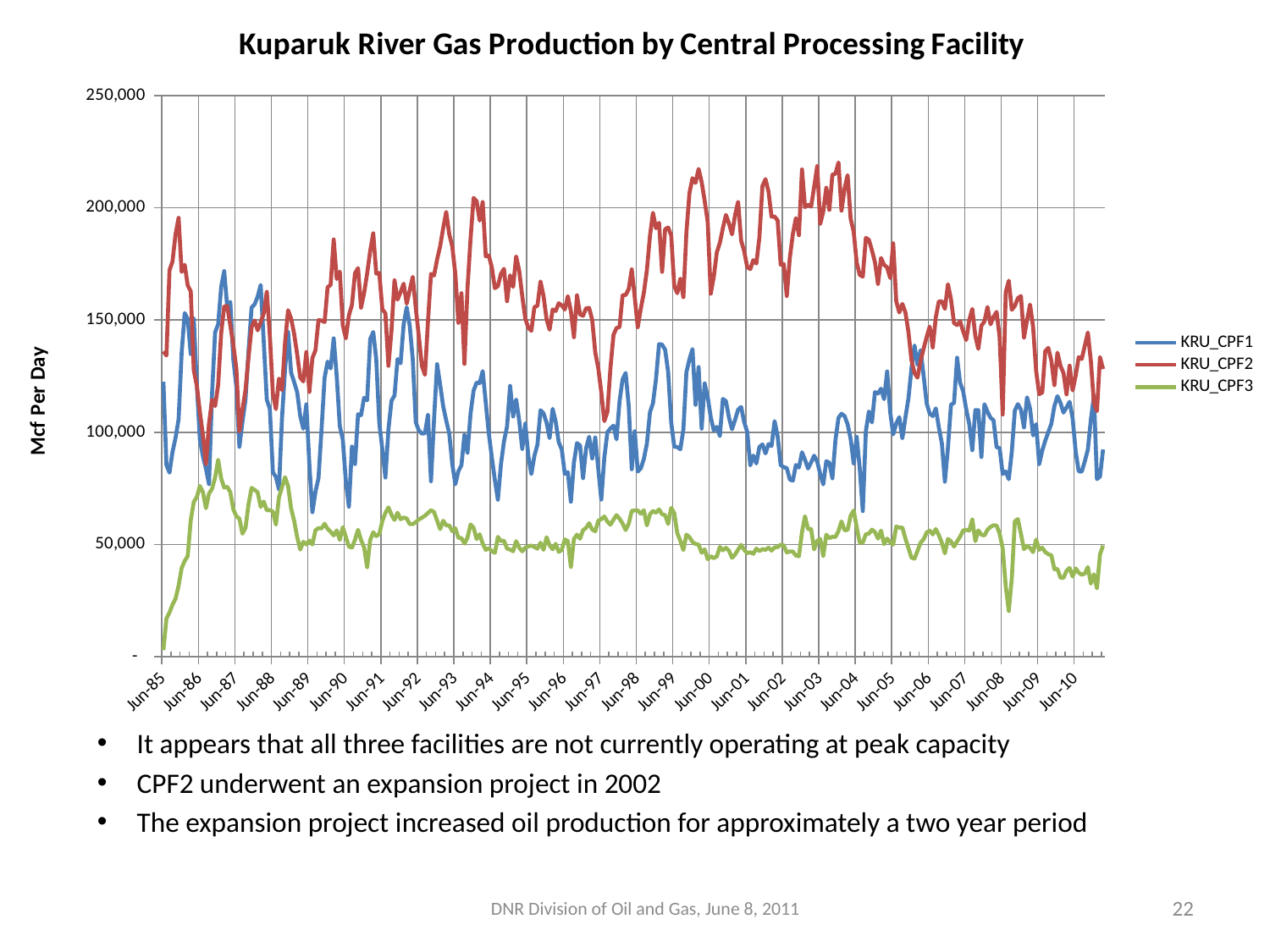
What is the title of the chart? Kuparuk River Gas Production by Central Processing Facility How many year labels are shown on the x axis? 26 How many series does the legend list? 3 What kind of chart is shown on the slide? line chart Is the value for KRU_CPF3 at Jun-85 greater or less than 50,000? less Which series has the lowest values across the whole chart? KRU_CPF3 What is the label on the vertical axis? Mcf Per Day Which series reaches the highest value on the chart? KRU_CPF2 Does the KRU_CPF2 series generally rise or fall from Jun-03 to Jun-10? fall Around Jun-03, which series is larger, KRU_CPF1 or KRU_CPF2? KRU_CPF2